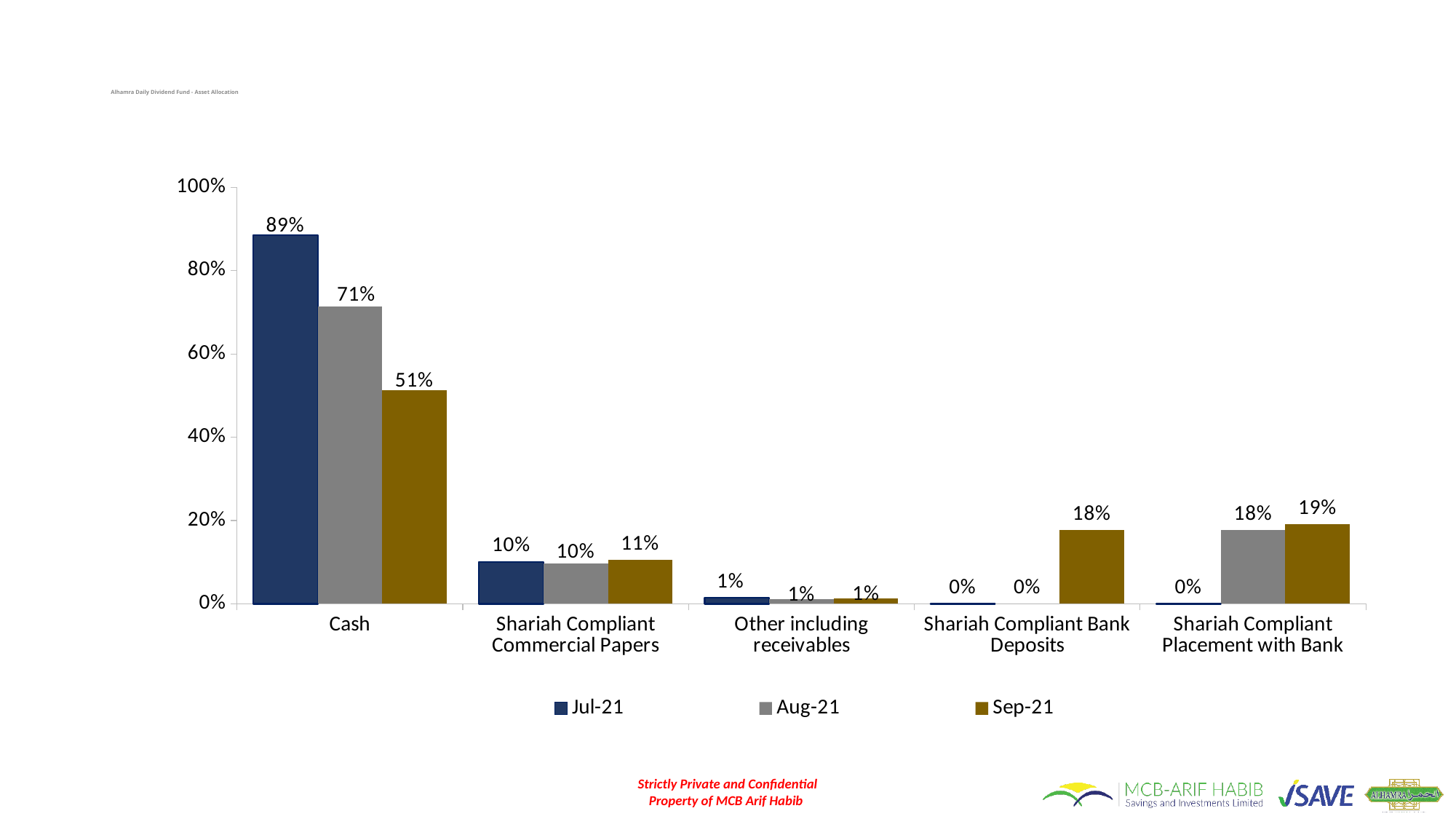
What is the value for Cash in the Jul-21 series? 89% What is the value for Shariah Compliant Bank Deposits in the Sep-21 series? 18% What kind of chart is shown on the slide? bar chart Is the Sep-21 value for Cash greater or less than 60%? less What is the value for Shariah Compliant Commercial Papers in the Sep-21 series? 11% How many categories are shown on the x axis? 5 Which category has the highest value in the Aug-21 series? Cash How many series does the legend list? 3 Does the value for Cash rise or fall from Jul-21 to Sep-21? fall Which is larger for Cash: the Aug-21 value or the Sep-21 value? Aug-21 What is the difference between the Jul-21 and Sep-21 values for Cash? 38% What is the value for Shariah Compliant Placement with Bank in the Aug-21 series? 18%